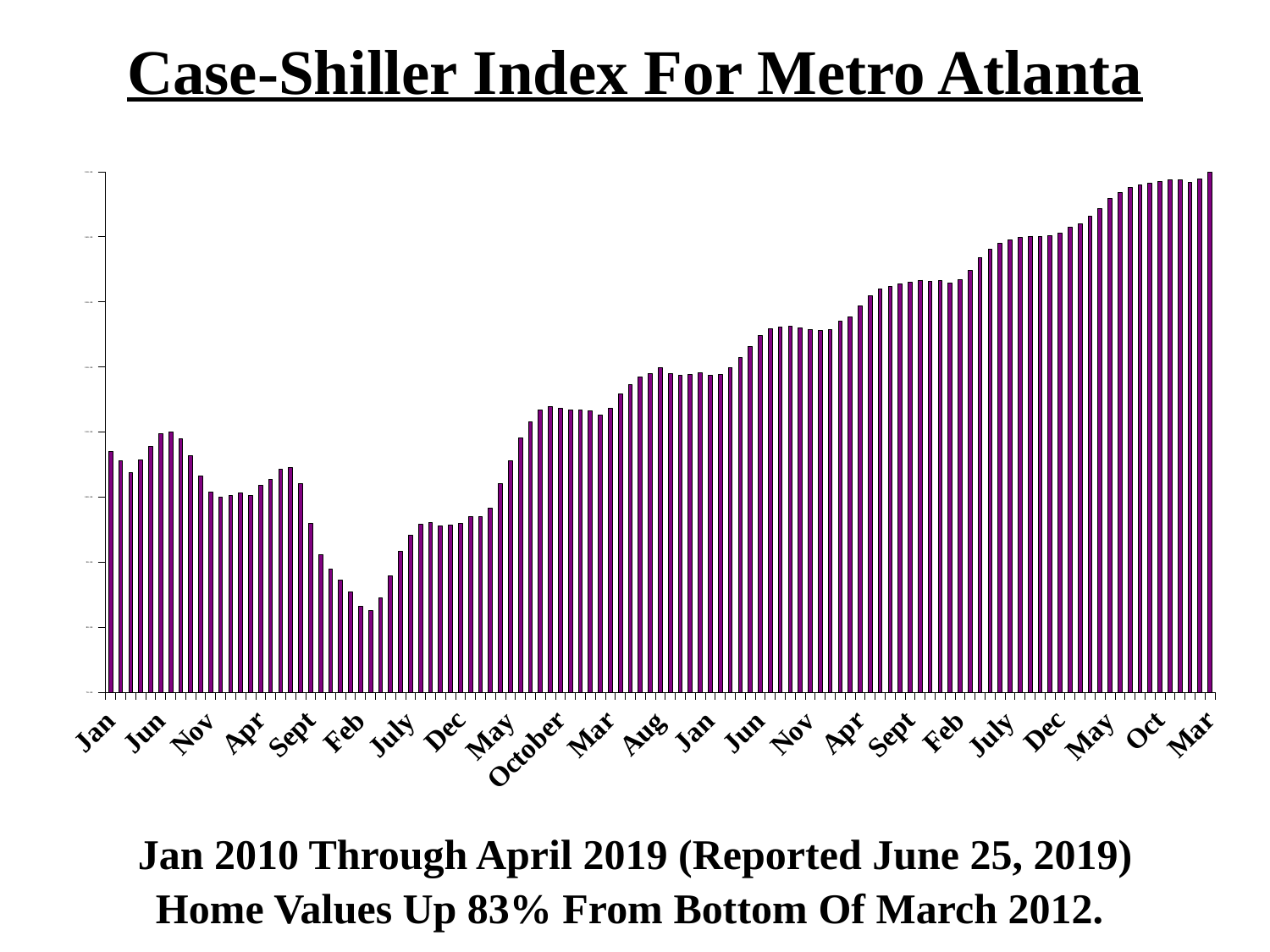
According to the slide, in which month and year did the index reach its bottom? March 2012 Which is larger, the bar at the first Feb label or the bar at the first July label? July What kind of chart is shown on the slide? bar chart Which is larger, the bar labelled Jan at the far left or the bar labelled Jun just to its right? Jun What colour are the bars in the chart? purple Which bar is the highest in the chart, the first one on the left or the last one on the right? the last one on the right Which is larger, the first bar (Jan 2010) or the last bar (Mar/Apr 2019)? the last bar Overall, do the bar values rise or fall from the left of the x axis to the right? rise Between the first Sept label and the first Feb label, do the bars rise or fall? fall Between the last Dec label and the last Mar label, do the bars rise or fall? rise By what percentage does the slide say home values are up from the bottom of March 2012? 83% What is the title of the chart? Case-Shiller Index For Metro Atlanta